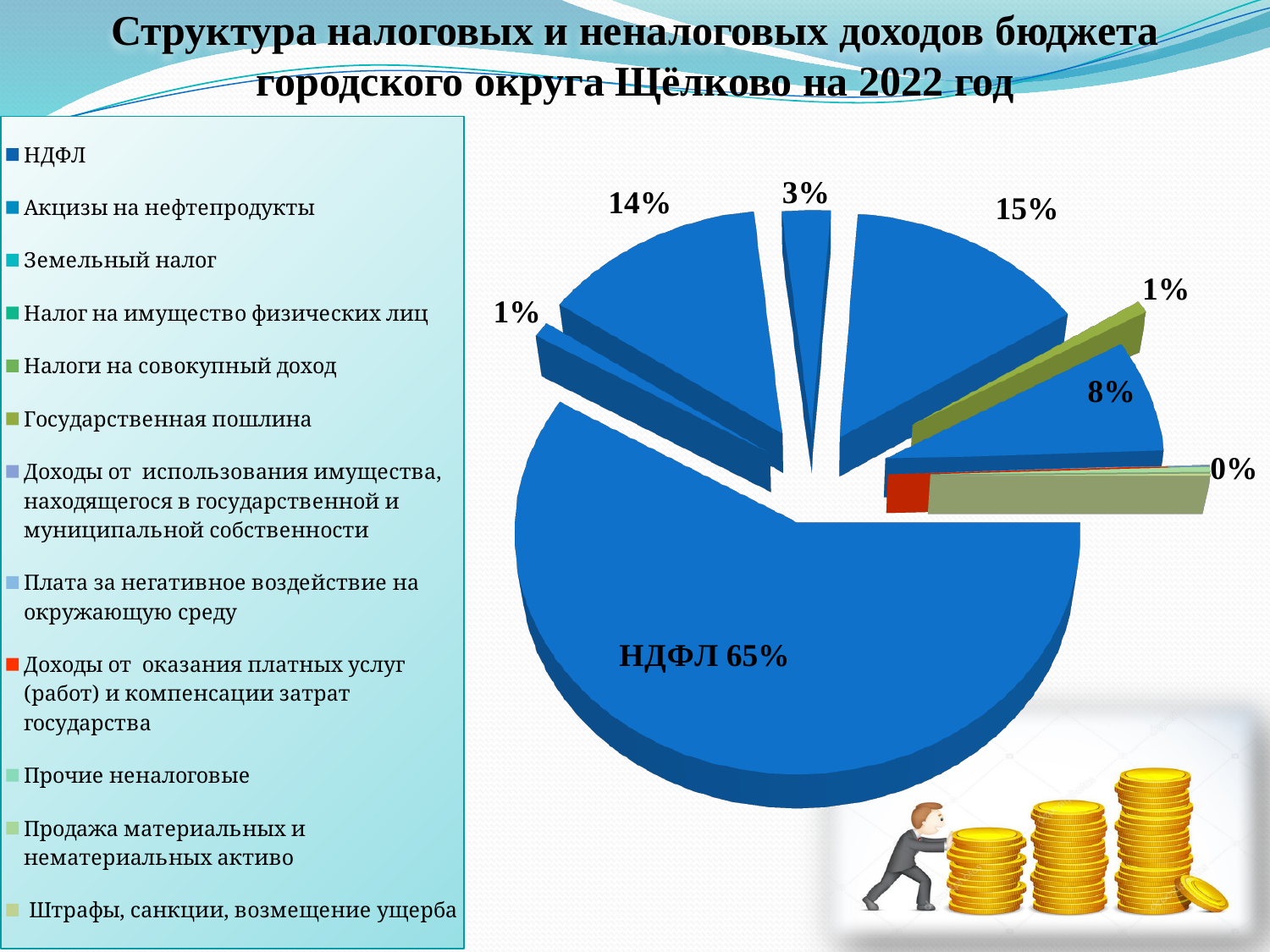
Which category has the largest slice of the pie? НДФЛ How many percentage data labels are shown on the pie? 8 What is the title of the chart? Структура налоговых и неналоговых доходов бюджета городского округа Щёлково на 2022 год What is the smallest percentage label shown on the pie? 0% What kind of chart is shown on the slide? pie chart Is the share for НДФЛ greater or less than 50%? greater Which entry appears first in the legend? НДФЛ What is the largest percentage label shown on the pie? 65% How many entries does the legend list? 12 What share of the pie does НДФЛ account for? 65% Which is larger: the НДФЛ slice at 65% or the slice labelled 15%? НДФЛ (65%) What is the difference between the largest label (65%) and the second-largest label (15%) on the pie? 50 percentage points